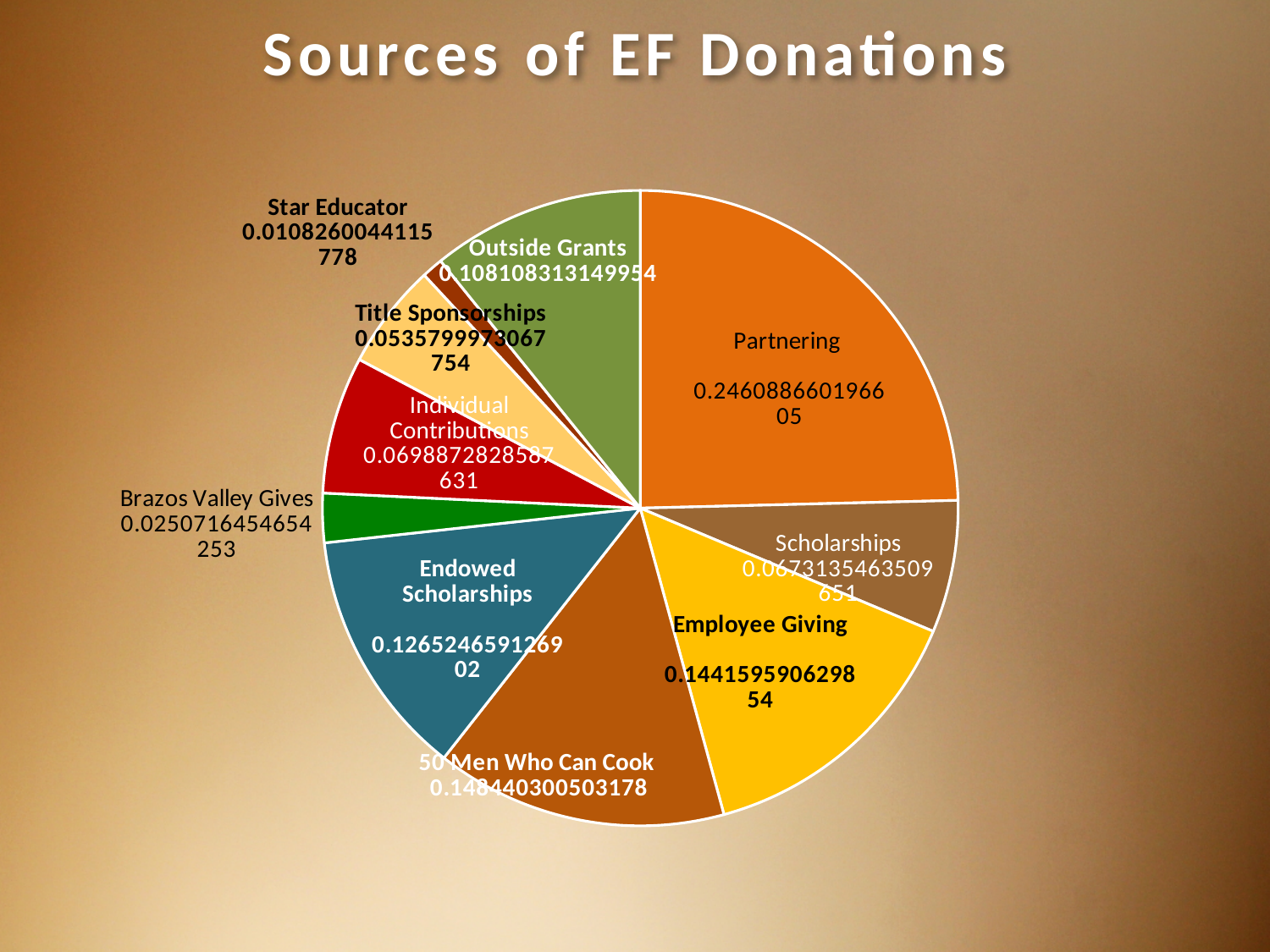
Which source has the largest share of EF donations? Partnering How many slices does the pie chart have? 10 What is the title of the chart? Sources of EF Donations What is the value shown for Partnering? 0.246088660196605 What is the value shown for Endowed Scholarships? 0.126524659126902 What kind of chart is shown on the slide? pie chart What is the value shown for Star Educator? 0.0108260044115778 Which source has the smallest share of EF donations? Star Educator What is the value shown for Employee Giving? 0.144159590629854 What is the value shown for Brazos Valley Gives? 0.0250716454654253 What is the value shown for Outside Grants? 0.108108313149954 Which is larger, Endowed Scholarships or Outside Grants? Endowed Scholarships